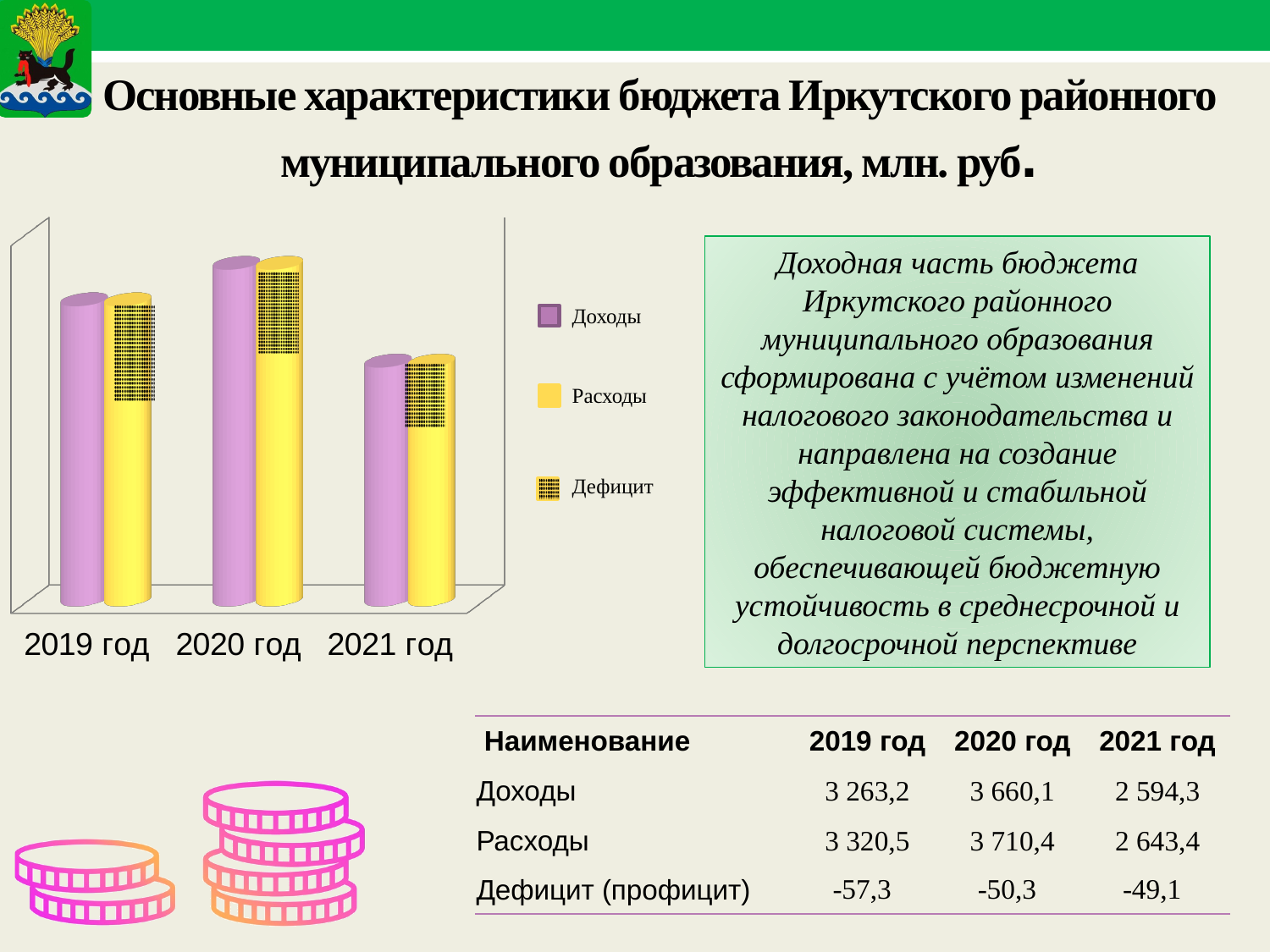
Using the table values, what is the difference between Расходы and Доходы in 2020 год? 50,3 Which legend entry is shown with a purple colour? Доходы According to the table on the slide, what is the value of Доходы for 2019 год? 3 263,2 What kind of chart is shown on the slide? bar chart According to the table on the slide, what is the Дефицит (профицит) value for 2020 год? -50,3 According to the table on the slide, what is the value of Расходы for 2021 год? 2 643,4 In 2020 год, which is larger: Доходы or Расходы? Расходы How many series does the chart legend list? 3 Which year has the lowest Расходы bar? 2021 год Which year has the highest Доходы bar? 2020 год Do the Доходы bars rise or fall from 2020 год to 2021 год? fall How many year categories are shown on the chart's x axis? 3